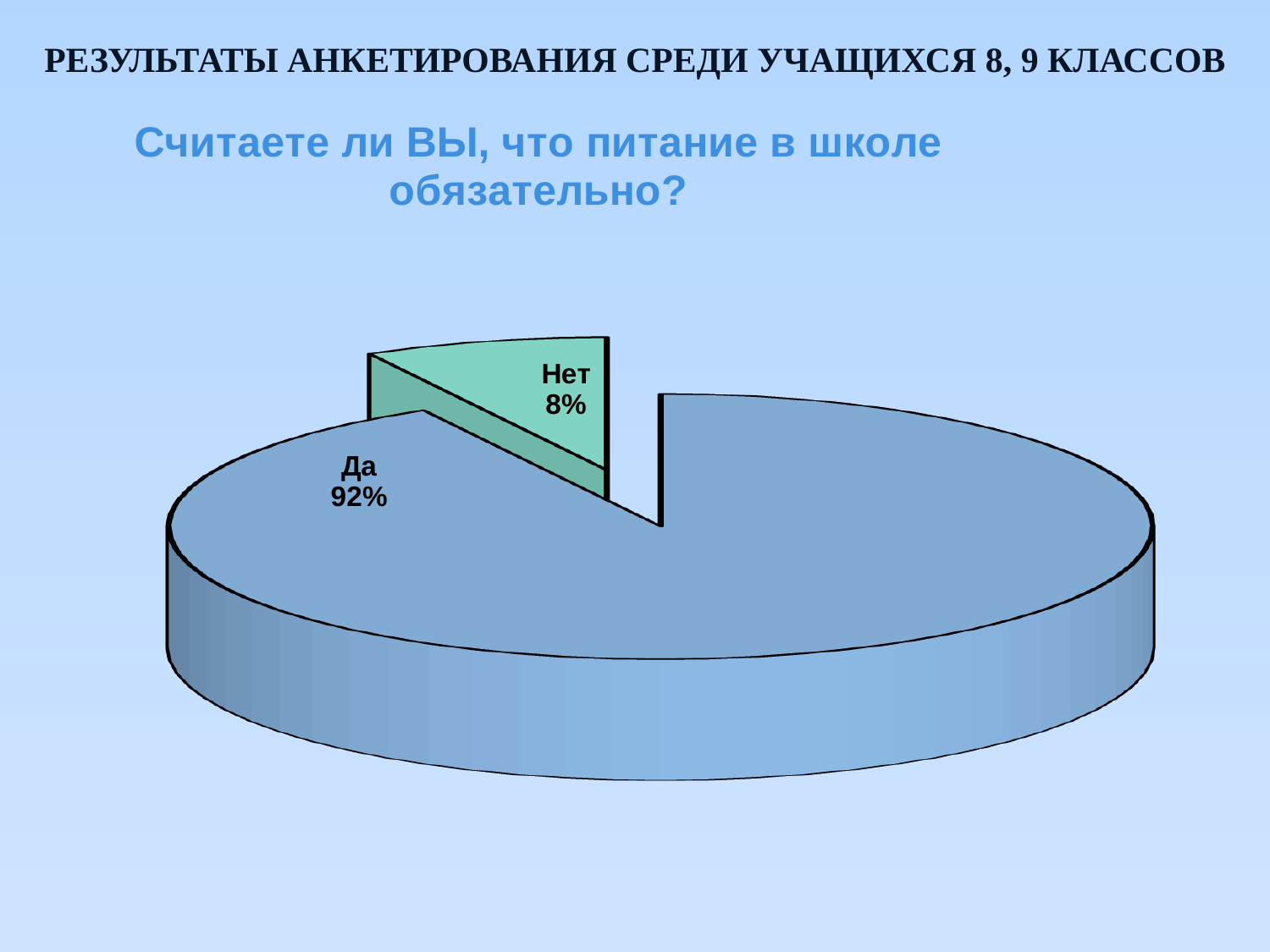
What question is the pie chart answering, as written above it? Считаете ли ВЫ, что питание в школе обязательно? What is the difference in percentage points between the "Да" and "Нет" slices? 84 What kind of chart is shown on the slide? pie chart What percentage of respondents answered "Да"? 92% How many slices does the pie chart have? 2 Which answer has the largest share of the pie? Да What share of the pie does the "Нет" slice represent? 8% What percentage of respondents answered "Нет"? 8% Which answer has the smallest share of the pie? Нет What colour is the "Нет" slice? green Which slice is larger, "Да" or "Нет"? Да